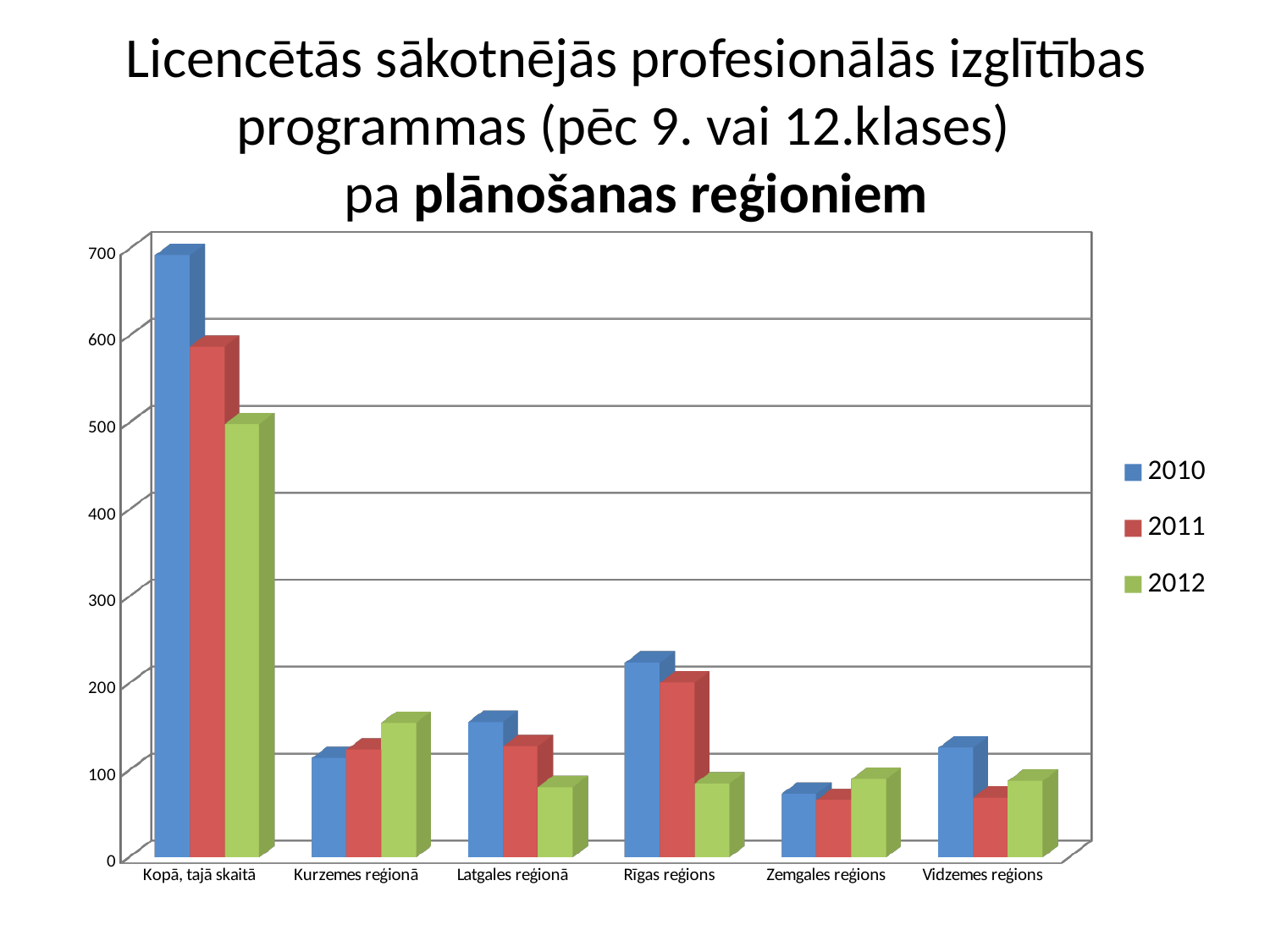
Among the regions (excluding Kopā, tajā skaitā), which has the highest value for 2012? Kurzemes reģionā For Kurzemes reģionā, do the values rise or fall from 2010 to 2012? rise Which is larger for 2010: Rīgas reģions or Latgales reģionā? Rīgas reģions Which category has the lowest value for 2010? Zemgales reģions Which category has the highest value for 2010? Kopā, tajā skaitā Is the 2010 value for Rīgas reģions greater or less than 200? greater What kind of chart is shown on the slide? bar chart Is the 2010 value for Kopā, tajā skaitā greater or less than 600? greater How many categories are shown on the x axis? 6 How many series does the legend list? 3 Is the 2012 value for Rīgas reģions greater or less than 100? less For Kopā, tajā skaitā, do the values rise or fall from 2010 to 2012? fall